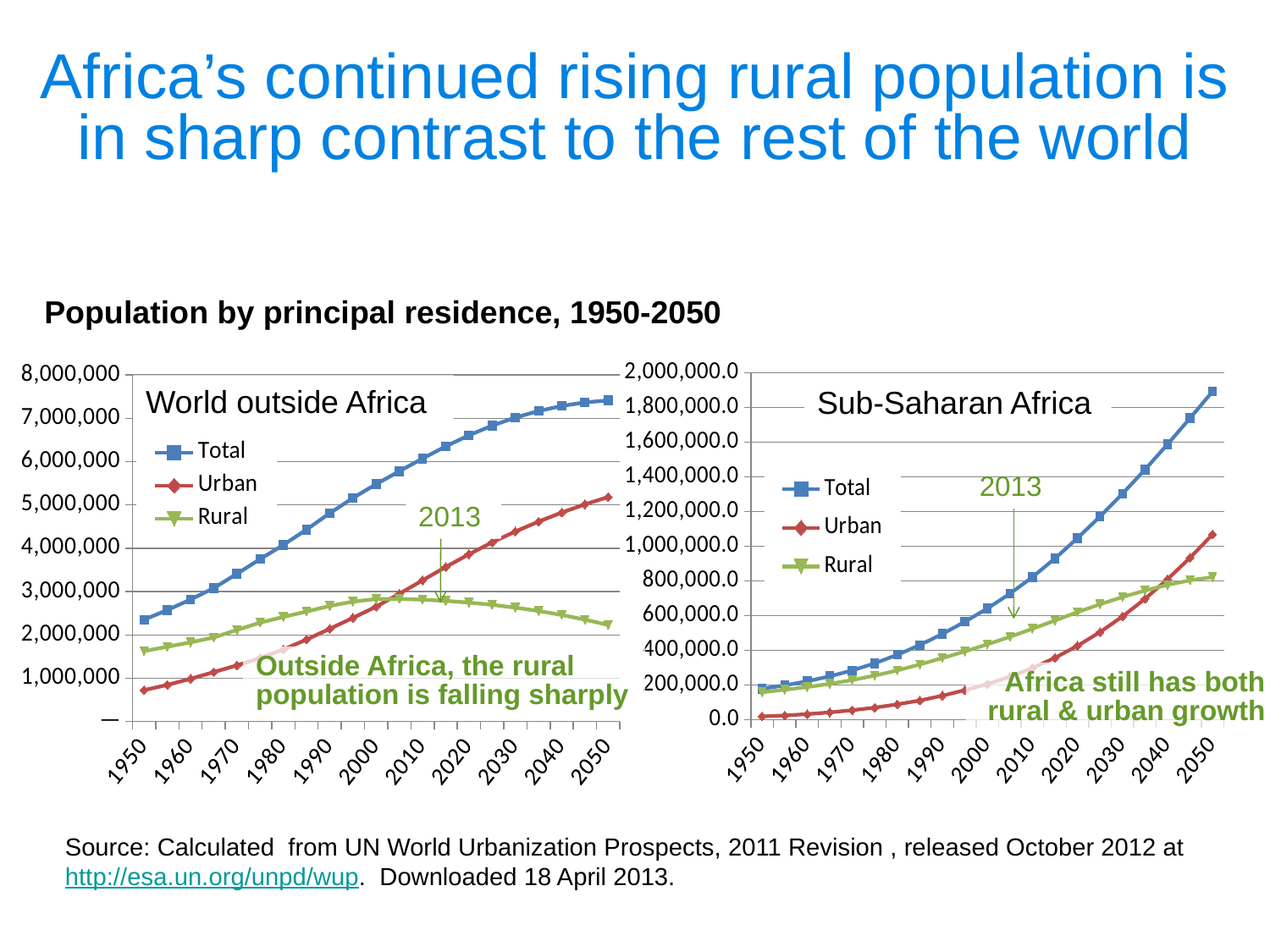
In the "World outside Africa" chart, which is larger in 2050, Urban or Rural? Urban How many series does the legend of the "Sub-Saharan Africa" chart list? 3 In the "Sub-Saharan Africa" chart, is the Total value for 2050 greater or less than 1,800,000.0? greater What kind of chart is the "World outside Africa" chart? line chart In the "Sub-Saharan Africa" chart, is the Rural value for 1950 greater or less than 200,000.0? less In the "World outside Africa" chart, does the Total series rise or fall from 1950 to 2050? rise In the "Sub-Saharan Africa" chart, which is larger in 1950, Urban or Rural? Rural In the "Sub-Saharan Africa" chart, which is larger in 2050, Urban or Rural? Urban In the "World outside Africa" chart, is the Total value for 2050 greater or less than 7,000,000? greater In the "Sub-Saharan Africa" chart, does the Rural series rise or fall from 1950 to 2050? rise How many year labels are shown on the x axis of the "World outside Africa" chart? 11